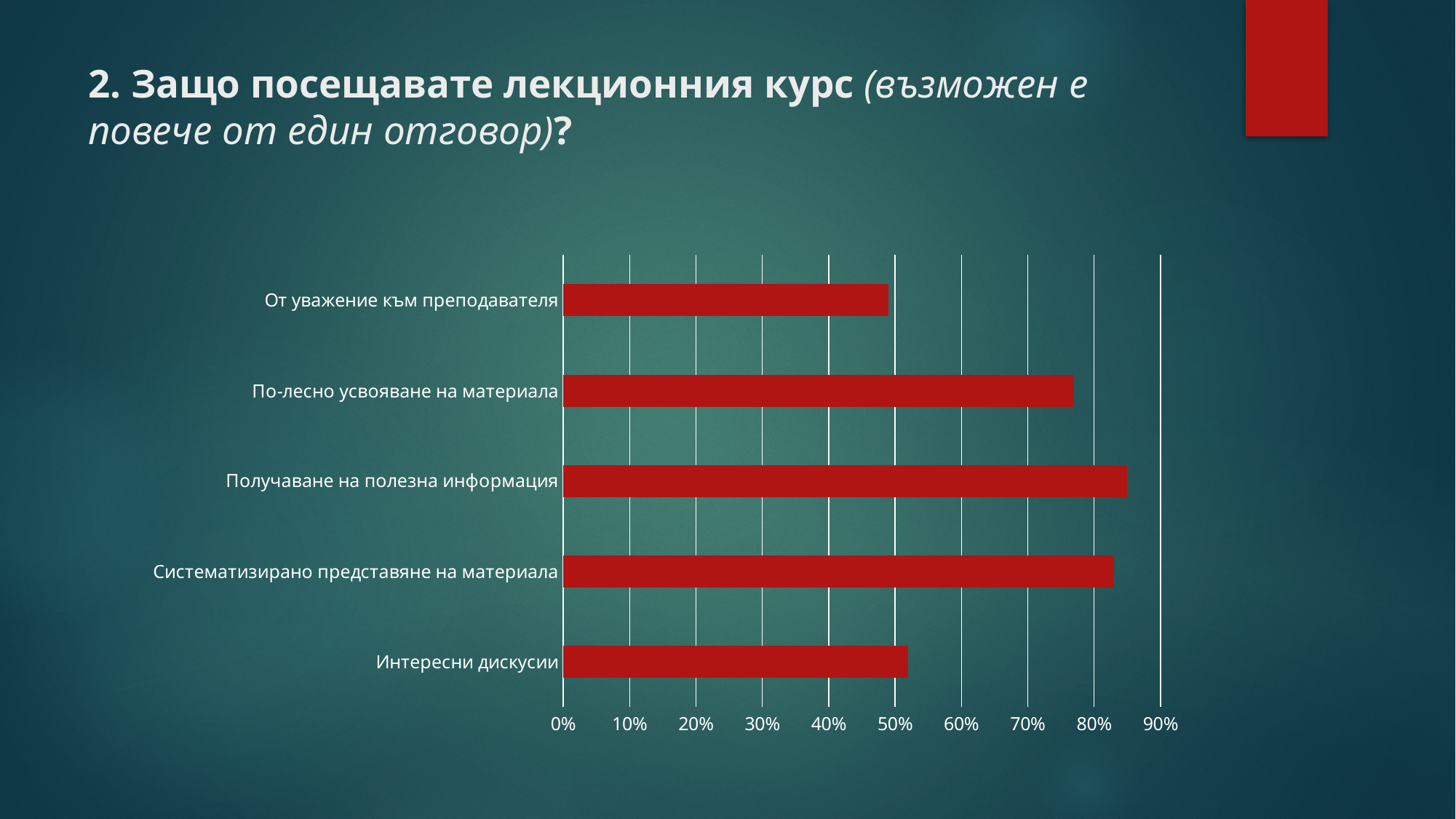
Which is larger: the value for "От уважение към преподавателя" or the value for "По-лесно усвояване на материала"? По-лесно усвояване на материала Is the value for "От уважение към преподавателя" greater or less than 40%? greater What kind of chart is shown on the slide? bar chart Is the value for "По-лесно усвояване на материала" greater or less than 80%? less Is the value for "Систематизирано представяне на материала" greater or less than 70%? greater How many categories are shown in the chart? 5 What is the highest value shown on the horizontal axis of the chart? 90% Which is larger: the value for "Получаване на полезна информация" or the value for "Интересни дискусии"? Получаване на полезна информация What colour are the bars in the chart? red